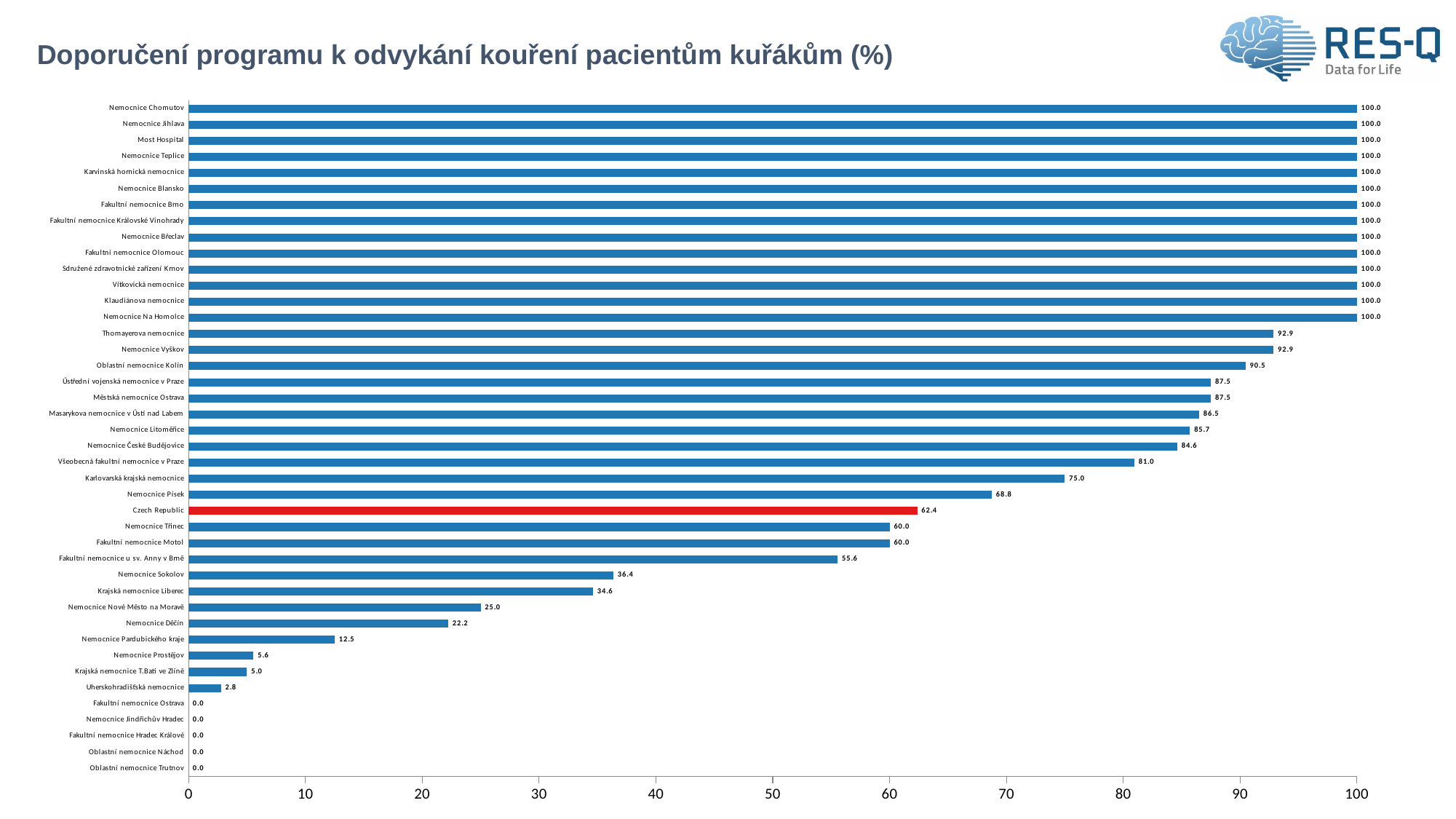
What is the title of the chart? Doporučení programu k odvykání kouření pacientům kuřákům (%) Which has a larger value, Nemocnice Děčín or Nemocnice Nové Město na Moravě? Nemocnice Nové Město na Moravě What is the difference between the values for Karlovarská krajská nemocnice and Nemocnice Sokolov? 38.6 Is the value for Nemocnice Pardubického kraje greater or less than 20? less Which bar is highlighted in red? Czech Republic What is the value for Nemocnice Písek? 68.8 What is the value for Oblastní nemocnice Kolín? 90.5 What kind of chart is shown on the slide? bar chart How many hospitals or categories are plotted on the chart? 42 What is the value for Czech Republic? 62.4 What is the value for Krajská nemocnice Liberec? 34.6 Is the value for Fakultní nemocnice u sv. Anny v Brně greater or less than 50? greater